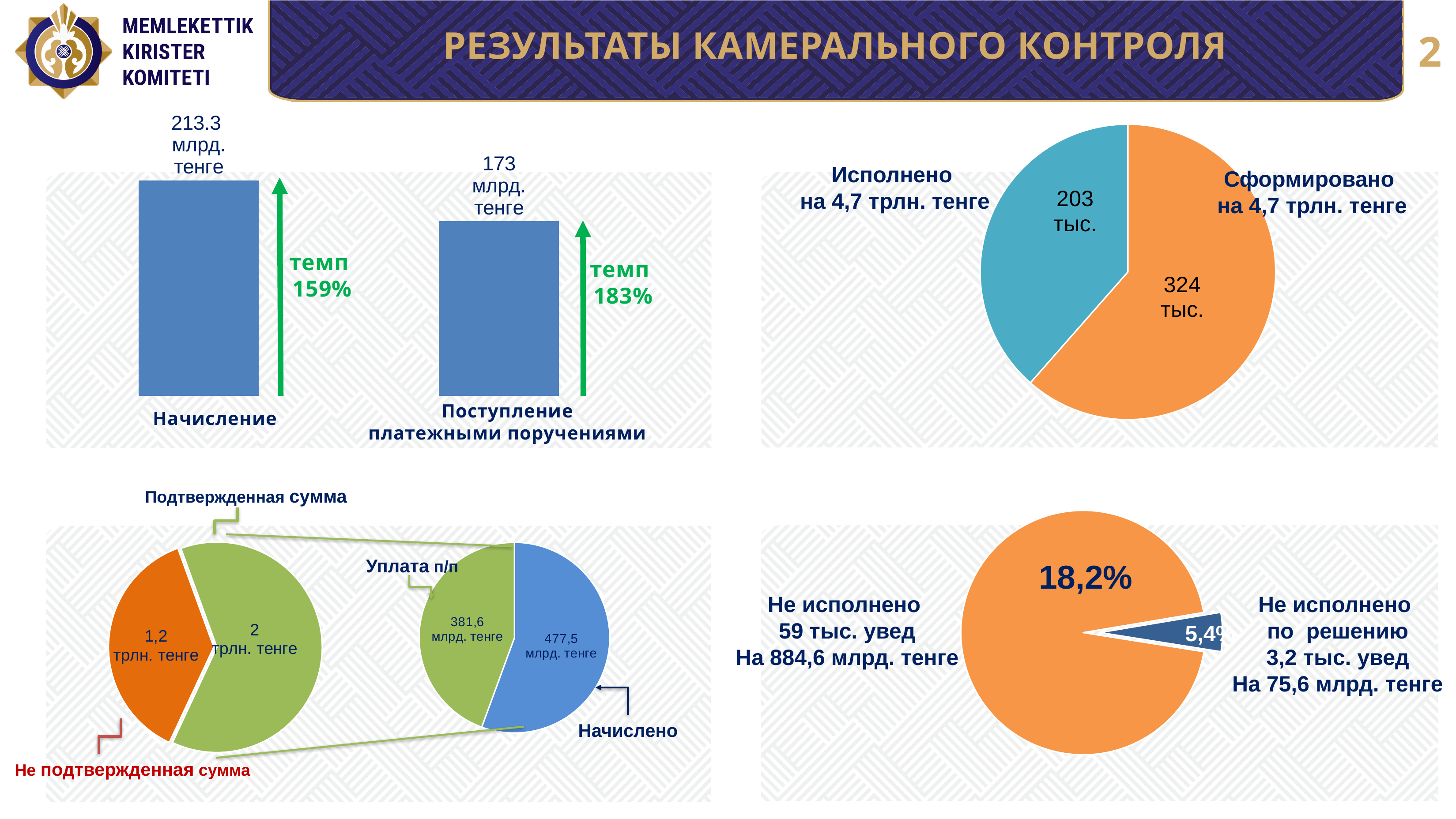
In the top-left bar chart, how many bars are shown? 2 What kind of chart is shown in the top-left of the slide? bar chart In the bottom-left pie chart, what is the value of the Не подтвержденная сумма slice? 1,2 трлн. тенге In the top-right pie chart, what is the value of the Сформировано slice? 324 тыс. In the bottom-right pie chart, what percentage is shown for the small dark blue slice? 5,4% In the top-left bar chart, which category has the higher value? Начисление In the bottom-left chart, what is the value of the Уплата п/п slice? 381,6 млрд. тенге In the top-right pie chart, what is the difference between the Сформировано and Исполнено values? 121 тыс. In the top-left bar chart, what is the value for Поступление платежными поручениями? 173 млрд. тенге In the top-right pie chart, which slice is larger, Исполнено or Сформировано? Сформировано In the top-right pie chart, what is the value of the Исполнено slice? 203 тыс. In the top-left bar chart, what is the value for Начисление? 213.3 млрд. тенге